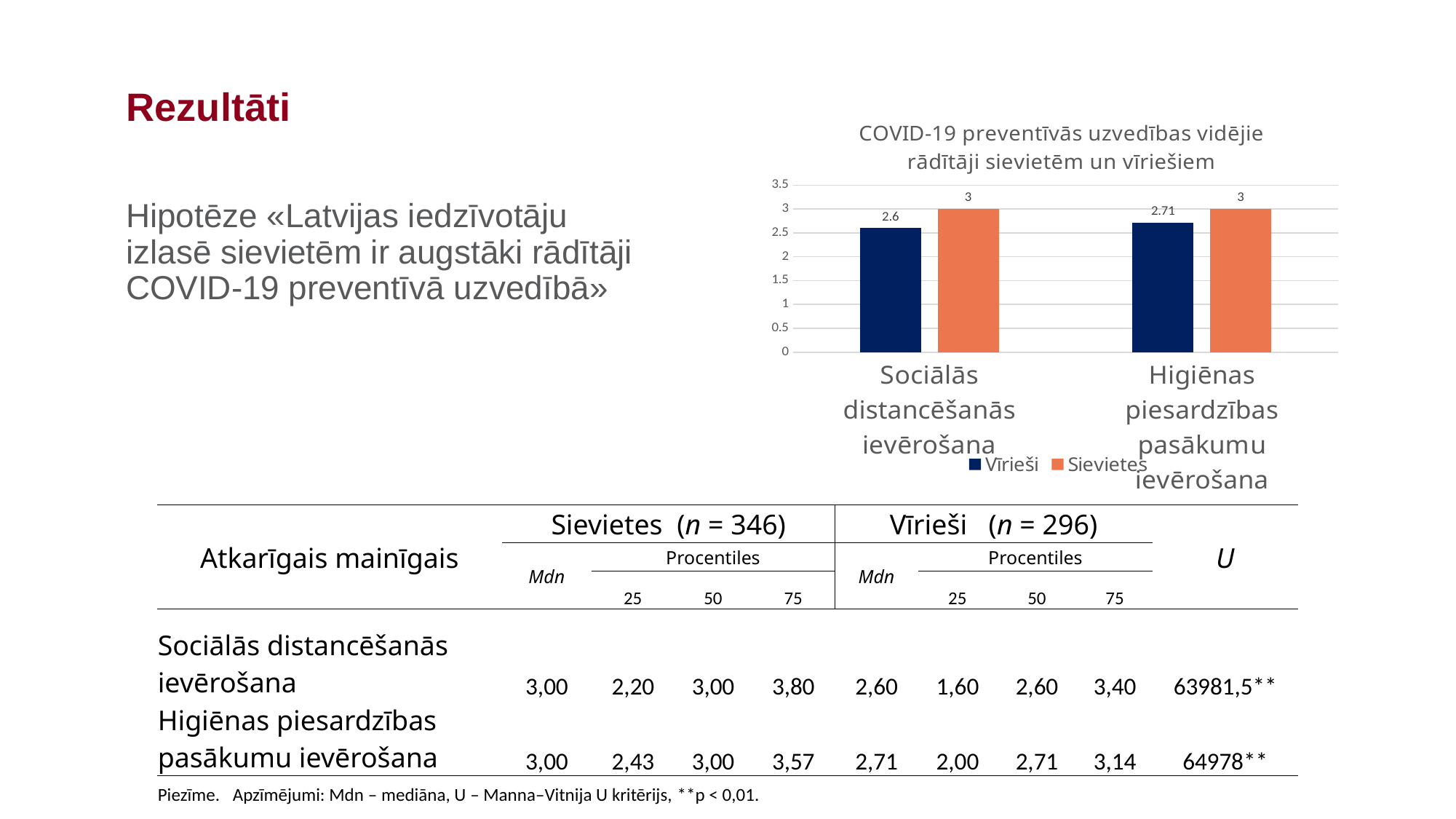
What is the value for Vīrieši in the Sociālās distancēšanās ievērošana category? 2.6 Is the value for Vīrieši in Sociālās distancēšanās ievērošana greater or less than 3? less What is the difference between the Sievietes and Vīrieši values for Higiēnas piesardzības pasākumu ievērošana? 0.29 Which series has the lower value in the Sociālās distancēšanās ievērošana category? Vīrieši How many categories are shown on the x axis of the chart? 2 What kind of chart is shown on the slide? bar chart What is the difference between the Sievietes and Vīrieši values for Sociālās distancēšanās ievērošana? 0.4 What is the value for Vīrieši in the Higiēnas piesardzības pasākumu ievērošana category? 2.71 What is the title of the chart? COVID-19 preventīvās uzvedības vidējie rādītāji sievietēm un vīriešiem What is the value for Sievietes in the Higiēnas piesardzības pasākumu ievērošana category? 3 How many series does the chart legend list? 2 Is the Vīrieši value for Higiēnas piesardzības pasākumu ievērošana larger or smaller than the Vīrieši value for Sociālās distancēšanās ievērošana? larger